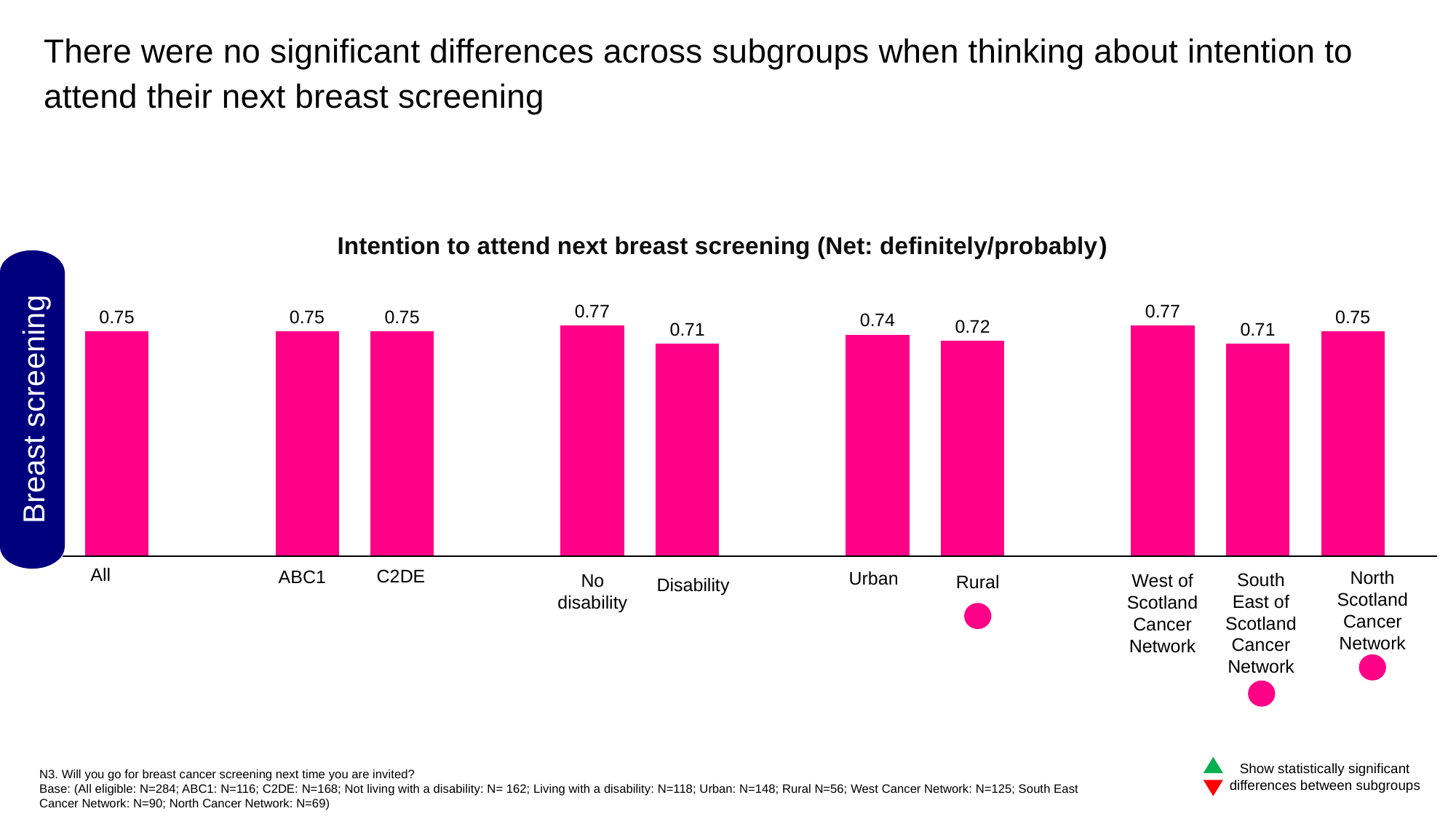
What is the difference between the values for No disability and Disability? 0.06 What is the difference between the values for West of Scotland Cancer Network and South East of Scotland Cancer Network? 0.06 How many bars are plotted in the chart? 10 What is the value for Rural? 0.72 What is the value for West of Scotland Cancer Network? 0.77 What is the value for No disability? 0.77 What is the value for South East of Scotland Cancer Network? 0.71 What type of chart is shown on the slide? Bar chart What is the value for Disability? 0.71 Which is higher, No disability or Disability? No disability What is the value for All in the Intention to attend next breast screening chart? 0.75 Which is higher, Urban or Rural? Urban